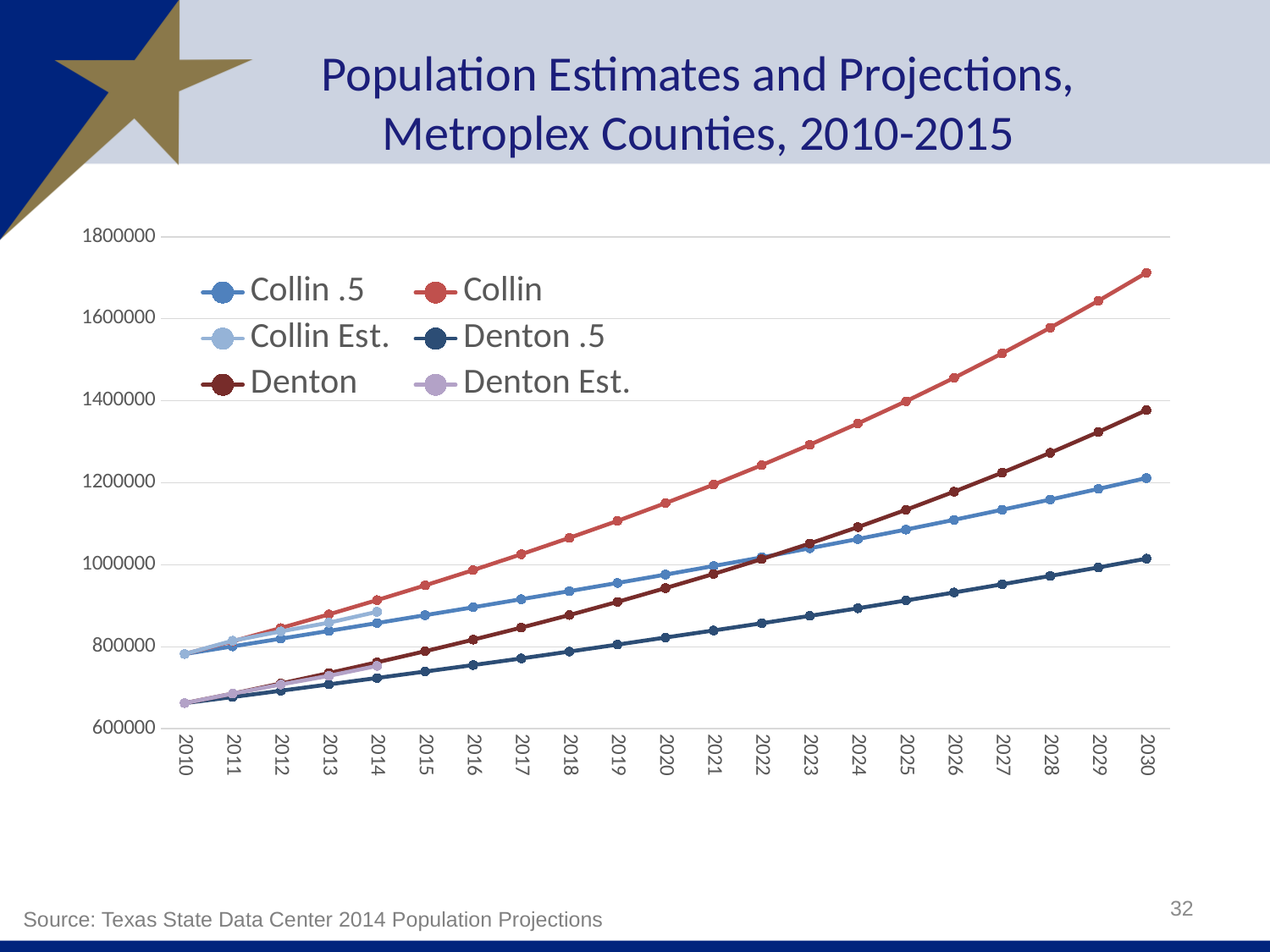
How many series does the legend list? 6 Is the value for Collin .5 in 2030 greater or less than 1400000? less How many years are shown along the x axis? 21 Is the value for Denton in 2025 greater or less than 1000000? greater Is the value for Collin in 2030 greater or less than 1600000? greater What kind of chart is shown on the slide? Line chart Does the Collin series rise or fall from 2010 to 2030? Rises In 2030, which is larger: Collin .5 or Denton? Denton Which series has the lowest value in 2030? Denton .5 What source is cited below the chart? Texas State Data Center 2014 Population Projections Which series has the highest value in 2030? Collin